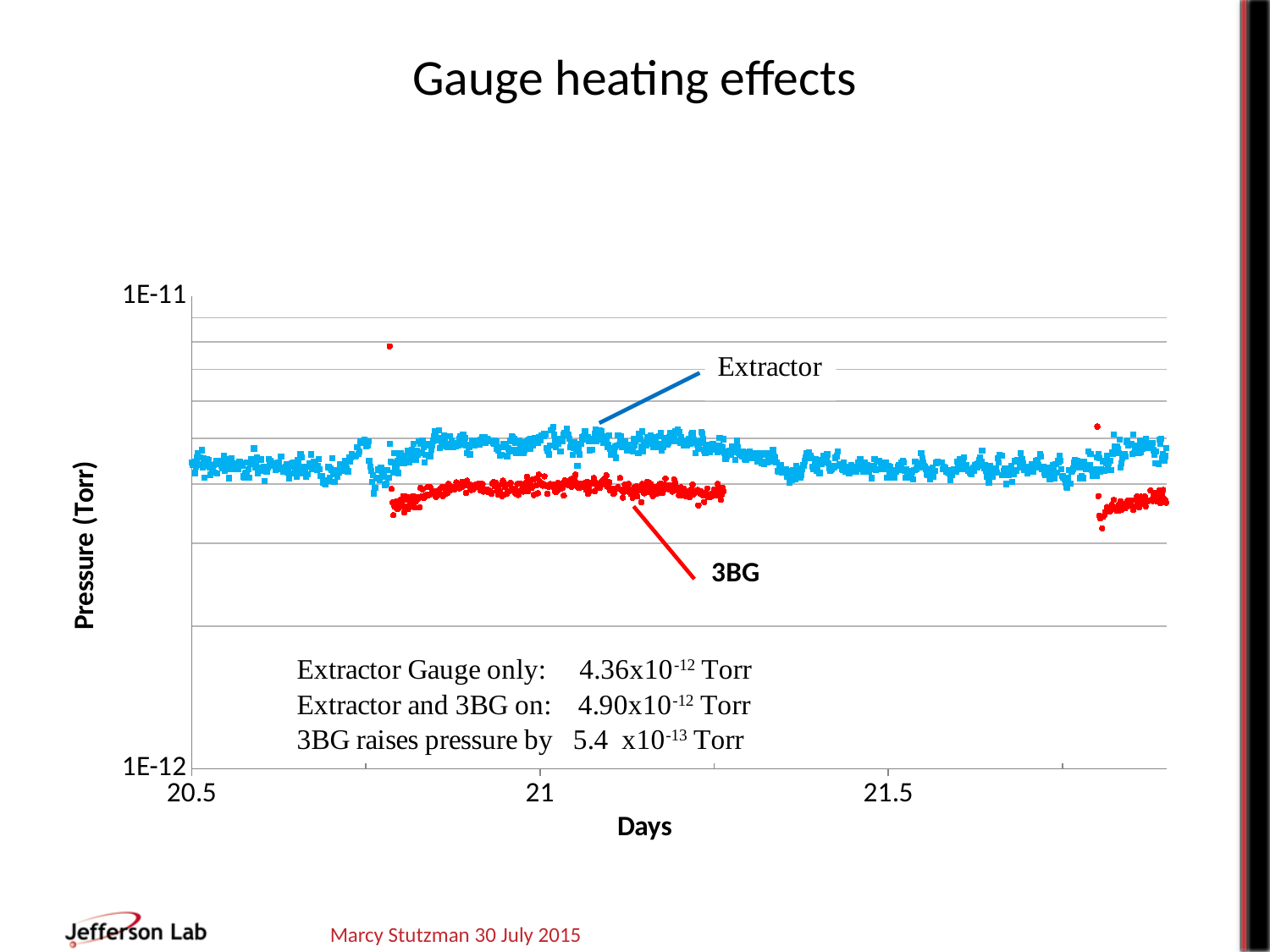
What is the label of the x axis? Days What is the title of the chart on the slide? Gauge heating effects Are the Extractor pressure values greater or less than 1E-11 Torr? less How many data series are plotted on the chart? 2 Which series shows higher pressure values, Extractor or 3BG? Extractor By how much does the 3BG raise the pressure, according to the annotation? 5.4 x10^-13 Torr According to the annotation, what is the pressure with the Extractor Gauge only? 4.36x10^-12 Torr What is the lowest value shown on the y axis? 1E-12 What type of chart is shown on the slide? Scatter chart According to the annotation, what is the pressure with the Extractor and 3BG on? 4.90x10^-12 Torr What are the names of the two series labelled on the chart? Extractor and 3BG What is the label of the y axis? Pressure (Torr)